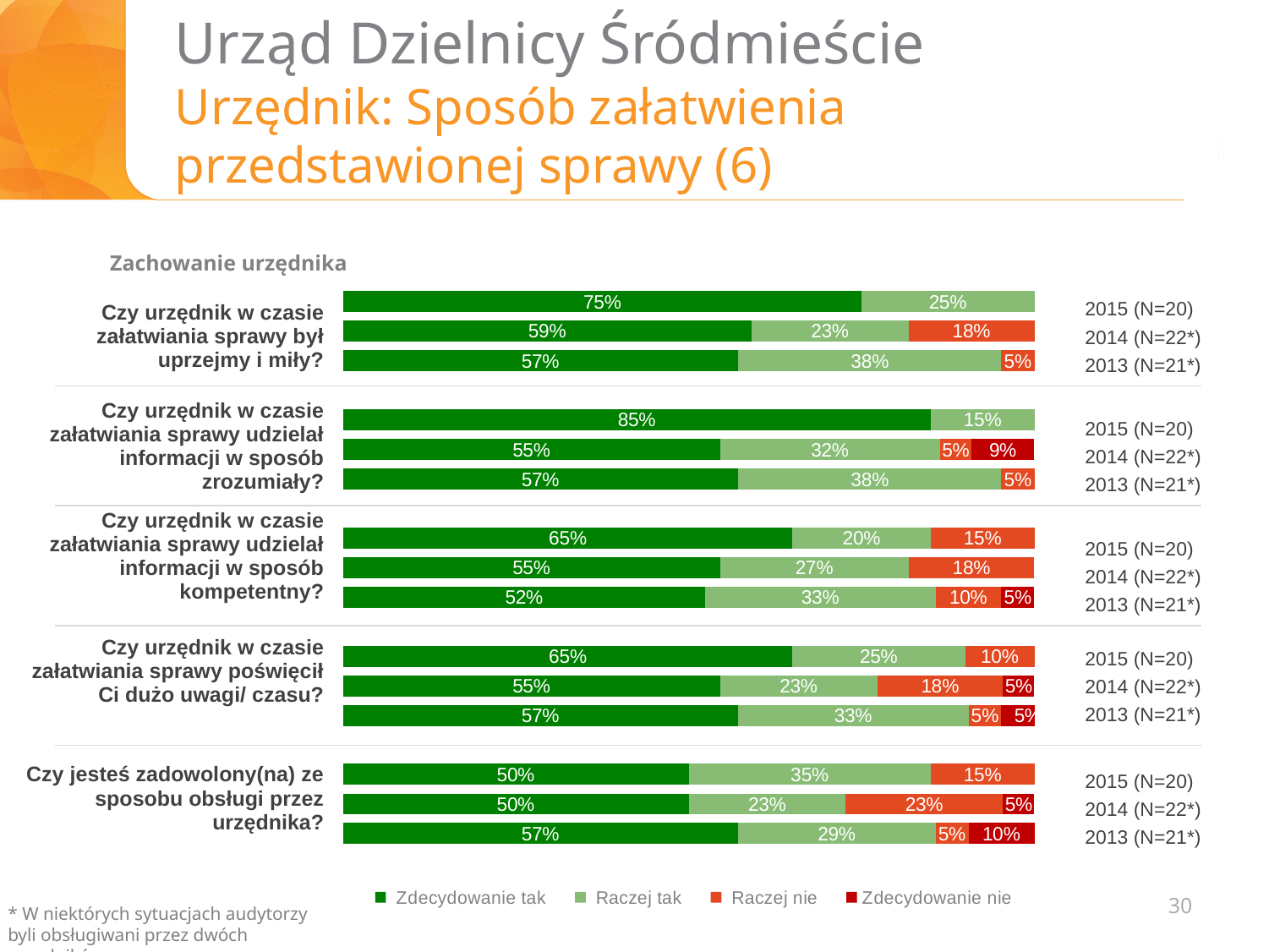
What is the 'Raczej tak' value for 2013 for the question 'Czy urzędnik w czasie załatwiania sprawy był uprzejmy i miły?' 38% Which legend entry is shown in dark red? Zdecydowanie nie How many survey questions (bar groups) are shown in the chart? 5 Across the three years for 'Czy urzędnik w czasie załatwiania sprawy udzielał informacji w sposób kompetentny?', which year has the lowest 'Zdecydowanie tak' value? 2013 For 'Czy urzędnik w czasie załatwiania sprawy poświęcił Ci dużo uwagi/ czasu?', which is larger: the 'Raczej tak' value for 2015 or for 2014? 2015 What type of chart is shown on the slide? stacked bar chart What is the difference between the 'Zdecydowanie tak' values for 2015 and 2014 for 'Czy urzędnik w czasie załatwiania sprawy udzielał informacji w sposób zrozumiały?' 30 percentage points Across the three years for 'Czy urzędnik w czasie załatwiania sprawy był uprzejmy i miły?', which year has the highest 'Zdecydowanie tak' value? 2015 What is the 'Raczej nie' value for 2014 for the question 'Czy jesteś zadowolony(na) ze sposobu obsługi przez urzędnika?' 23% What is the sample size (N) shown for 2015? N=20 How many series does the legend list? 4 What is the 'Zdecydowanie tak' value for 2015 for the question 'Czy urzędnik w czasie załatwiania sprawy udzielał informacji w sposób zrozumiały?' 85%